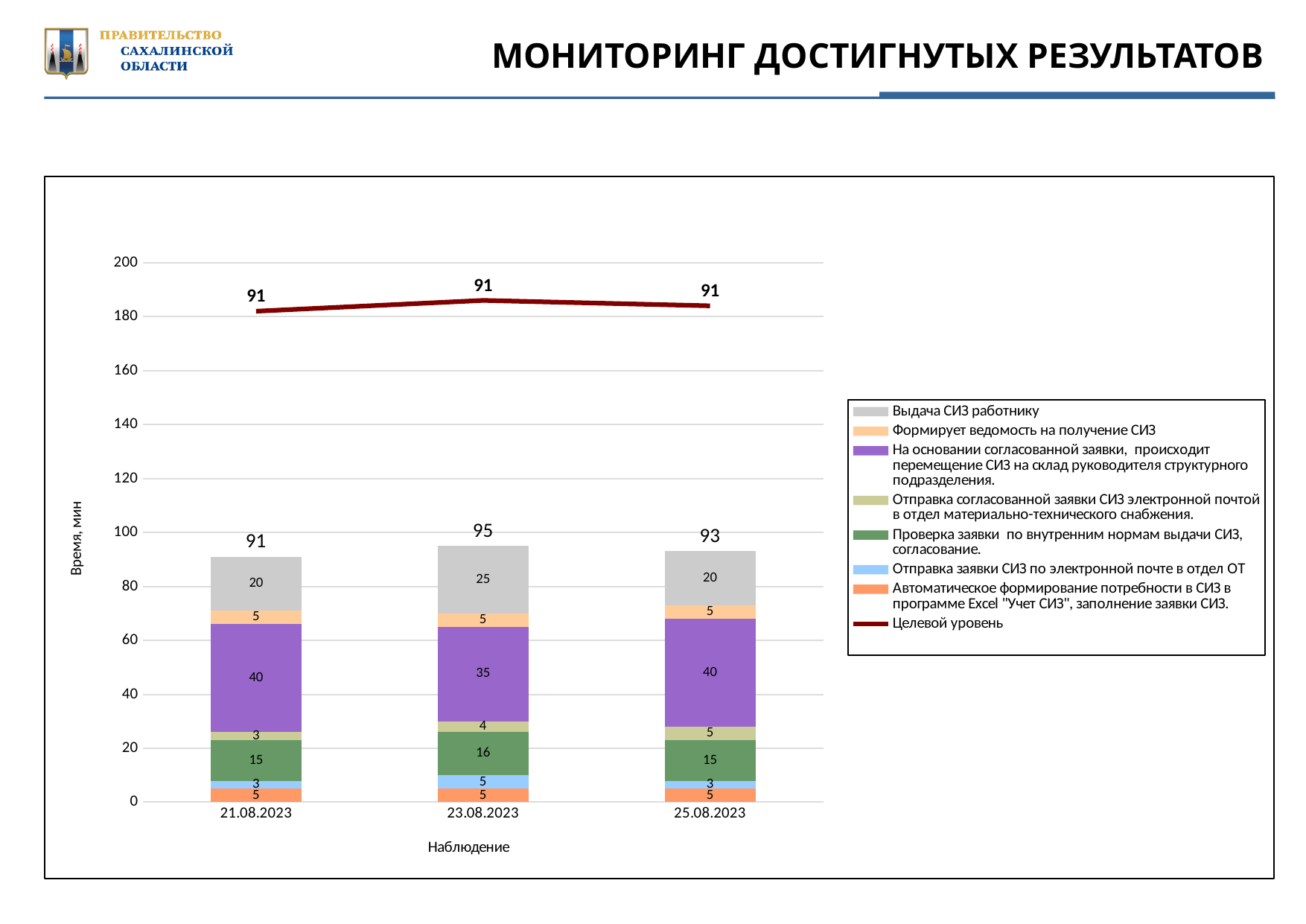
What is the value of the 'Целевой уровень' line at 25.08.2023? 91 What is the label of the x axis? Наблюдение Which observation date has the highest stacked bar total? 23.08.2023 What is the label of the y axis? Время, мин What is the total of the stacked bar for 23.08.2023? 95 What is the value of the 'Проверка заявки по внутренним нормам выдачи СИЗ, согласование' segment for 21.08.2023? 15 How many entries does the legend list? 8 What is the value of the 'Выдача СИЗ работнику' segment for 23.08.2023? 25 Which observation date has the lowest stacked bar total? 21.08.2023 Is the purple segment ('На основании согласованной заявки...') larger for 21.08.2023 or for 23.08.2023? 21.08.2023 What is the difference between the stacked bar totals for 23.08.2023 and 25.08.2023? 2 How many observation dates are shown on the x axis? 3